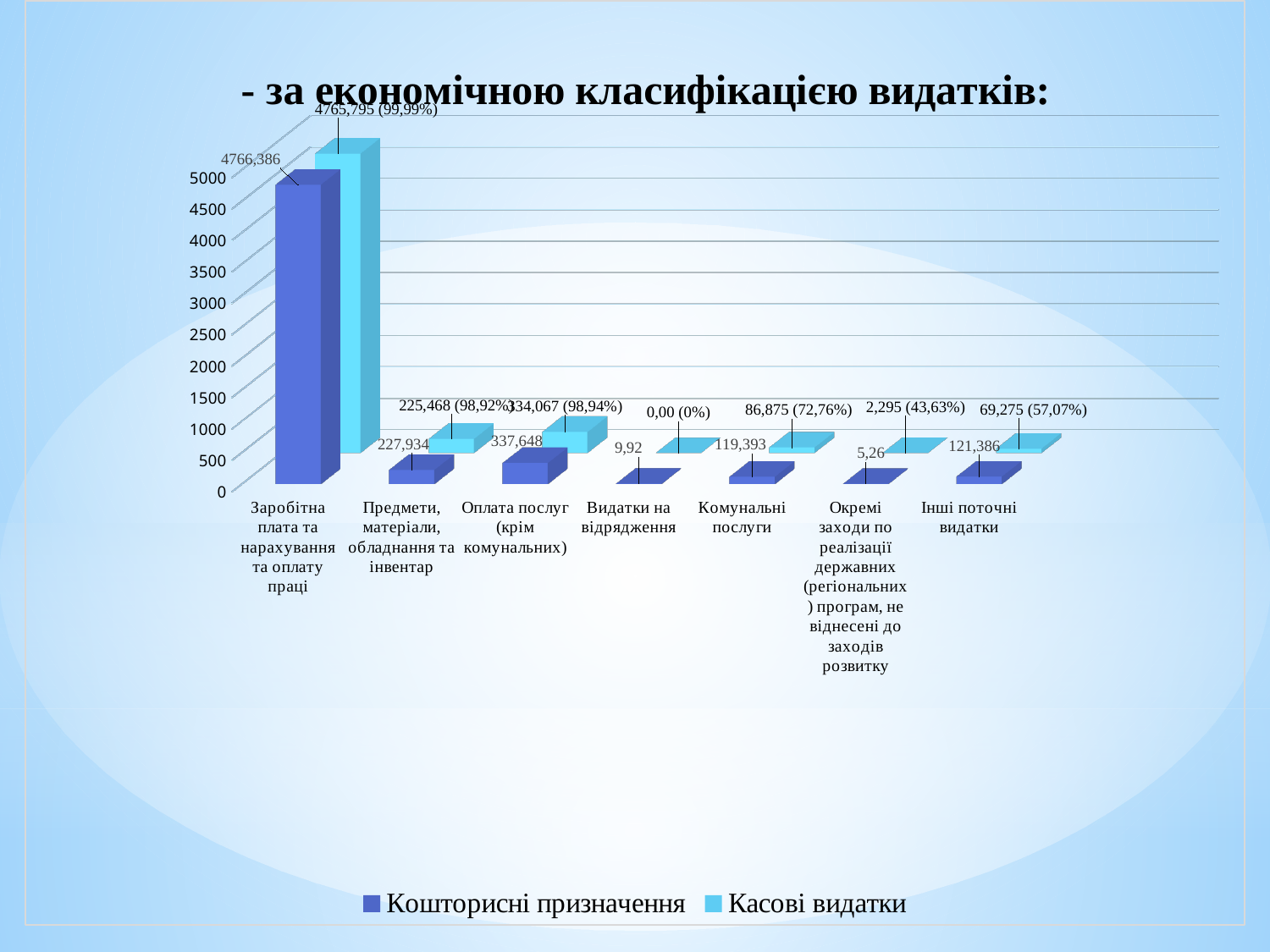
Which category has the highest value for Кошторисні призначення? Заробітна плата та нарахування та оплату праці What kind of chart is shown on the slide? bar chart What is the difference between Кошторисні призначення and Касові видатки for Інші поточні видатки? 52,111 How many categories are shown on the x axis? 7 Which category has the lowest value for Касові видатки? Видатки на відрядження What is the value of Кошторисні призначення for Заробітна плата та нарахування та оплату праці? 4766,386 What is the data label for Касові видатки for Комунальні послуги? 86,875 (72,76%) Which is larger for Комунальні послуги: Кошторисні призначення or Касові видатки? Кошторисні призначення What is the data label for Касові видатки for Видатки на відрядження? 0,00 (0%) What are the two series named in the legend? Кошторисні призначення and Касові видатки What is the value of Кошторисні призначення for Інші поточні видатки? 121,386 How many series does the legend list? 2